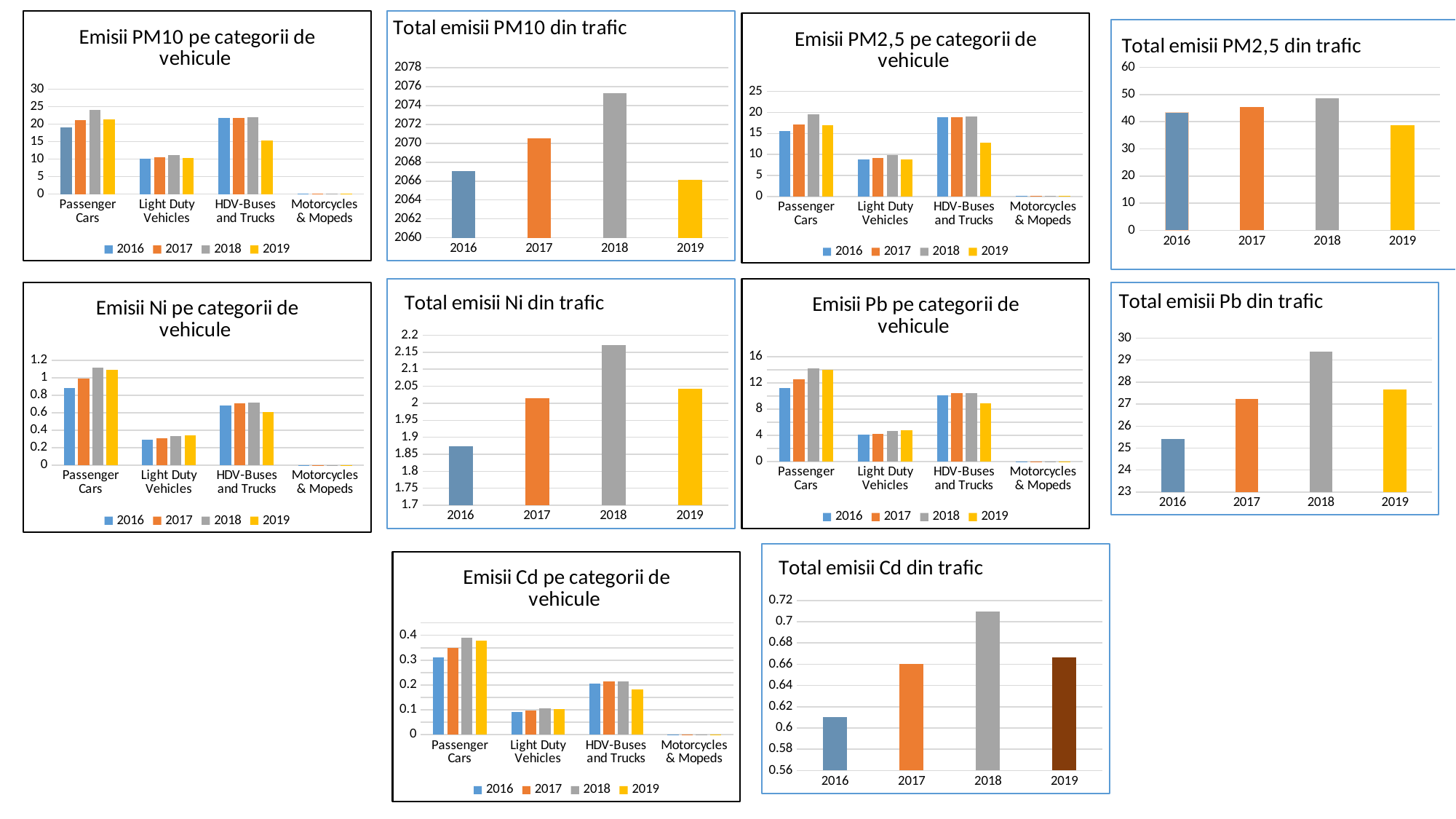
In the chart titled "Total emisii PM2,5 din trafic", which year has the lowest value? 2019 In the chart titled "Total emisii Ni din trafic", is the value for 2016 greater or less than 1.9? less In the chart titled "Total emisii Cd din trafic", what colour is the bar for 2019? dark brown How many series does the legend list in the chart titled "Emisii PM10 pe categorii de vehicule"? 4 In the chart titled "Total emisii PM10 din trafic", which year has the highest value? 2018 What kind of chart is "Total emisii Pb din trafic"? bar chart In the chart titled "Total emisii Cd din trafic", is the value for 2018 greater or less than 0.7? greater In the chart titled "Emisii PM10 pe categorii de vehicule", which vehicle category has the lowest values? Motorcycles & Mopeds How many vehicle categories are shown on the x axis of the chart titled "Emisii Ni pe categorii de vehicule"? 4 In the chart titled "Emisii Cd pe categorii de vehicule", which is larger for 2016: Passenger Cars or HDV-Buses and Trucks? Passenger Cars In the chart titled "Total emisii Pb din trafic", is the value for 2018 greater or less than 29? greater In the chart titled "Total emisii Cd din trafic", which year has the lowest value? 2016